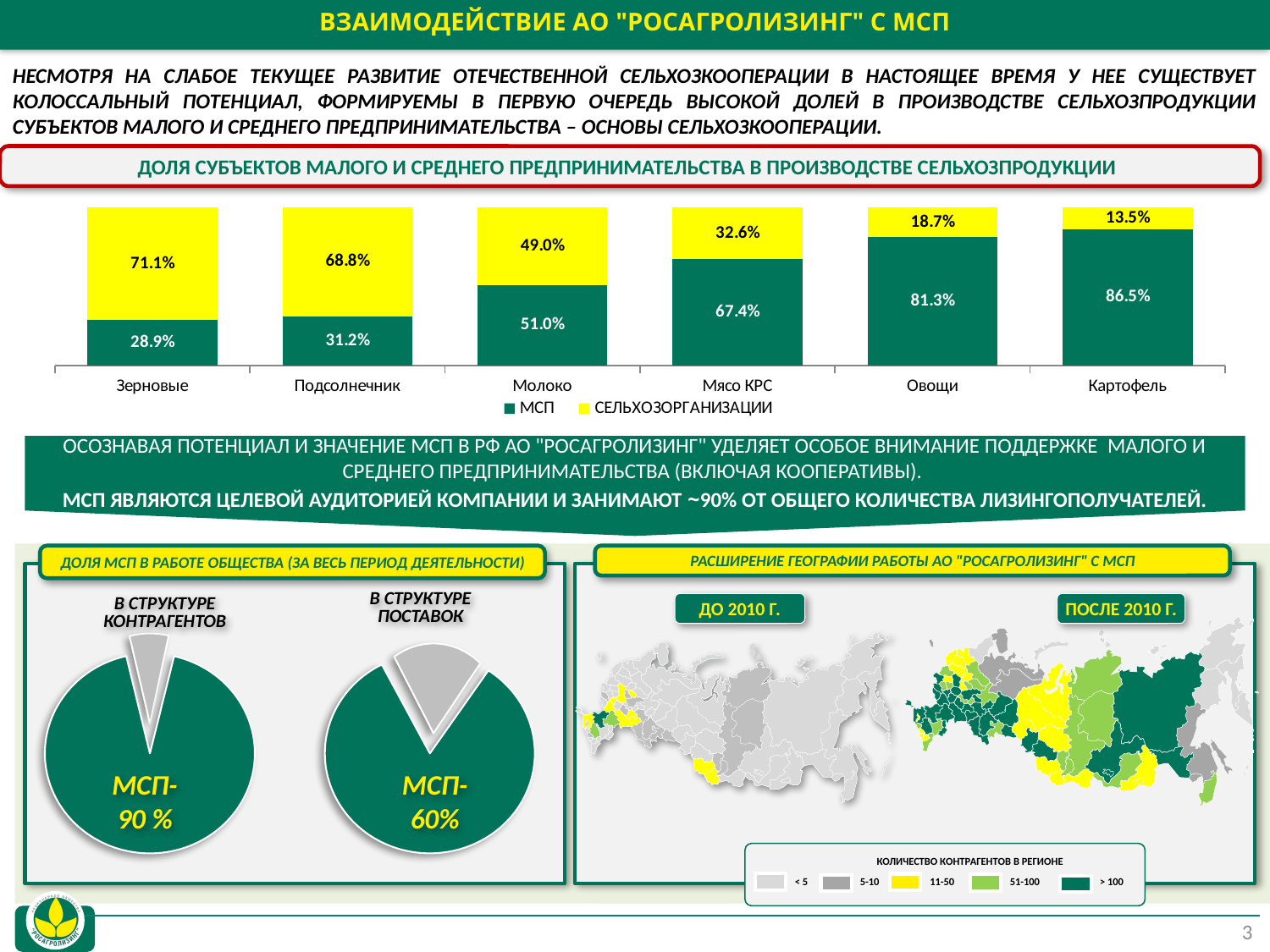
How many series does the legend of the stacked bar chart on the share of small and medium enterprises in agricultural production list? 2 In the stacked bar chart on the share of small and medium enterprises in agricultural production, which is larger: the МСП value for Подсолнечник or for Мясо КРС? Мясо КРС In the stacked bar chart on the share of small and medium enterprises in agricultural production, what is the МСП value for Картофель? 86.5% In the stacked bar chart on the share of small and medium enterprises in agricultural production, what is the СЕЛЬХОЗОРГАНИЗАЦИИ value for Зерновые? 71.1% How many categories are shown in the stacked bar chart on the share of small and medium enterprises in agricultural production? 6 In the stacked bar chart on the share of small and medium enterprises in agricultural production, what is the difference between the МСП values for Овощи and Мясо КРС? 13.9% In the stacked bar chart on the share of small and medium enterprises in agricultural production, what is the МСП value for Молоко? 51.0% In the pie chart titled 'В СТРУКТУРЕ КОНТРАГЕНТОВ', what share is labelled for МСП? 90 % In the pie chart titled 'В СТРУКТУРЕ ПОСТАВОК', what share is labelled for МСП? 60% In the stacked bar chart on the share of small and medium enterprises in agricultural production, which category has the lowest МСП value? Зерновые In the stacked bar chart on the share of small and medium enterprises in agricultural production, which category has the highest МСП value? Картофель What kind of chart is used to show the share of small and medium enterprises in agricultural production? Stacked bar chart